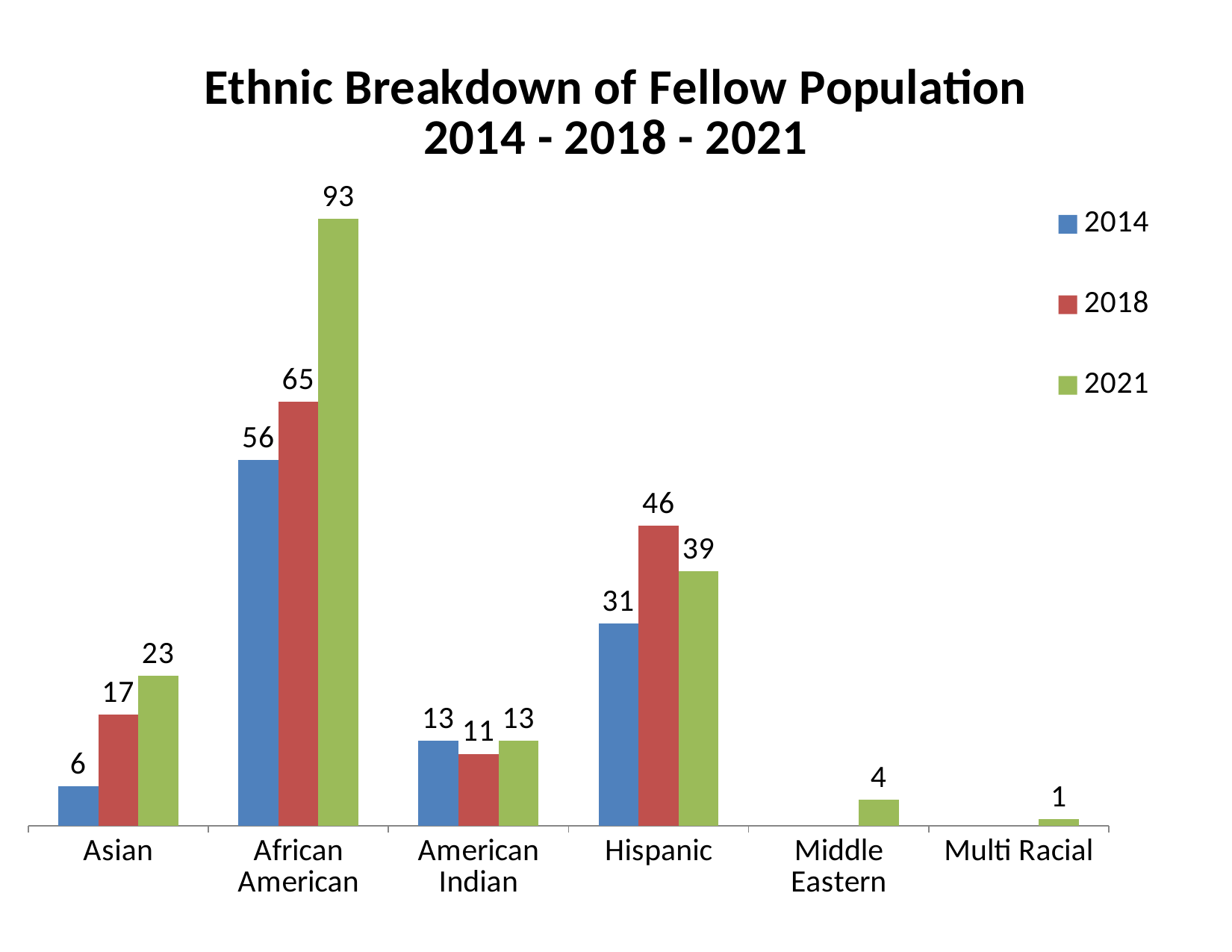
What is the value for Middle Eastern in 2021? 4 What is the title of the chart? Ethnic Breakdown of Fellow Population 2014 - 2018 - 2021 What is the value for Asian in 2014? 6 How many categories are shown on the x axis? 6 Which category has the lowest value in 2021? Multi Racial What is the value for African American in 2021? 93 What kind of chart is this? Bar chart Which is larger for Hispanic: the 2018 value or the 2021 value? 2018 How many series does the legend list? 3 Which category has the highest value in 2021? African American What is the difference between the 2021 and 2014 values for African American? 37 What is the value for Hispanic in 2018? 46